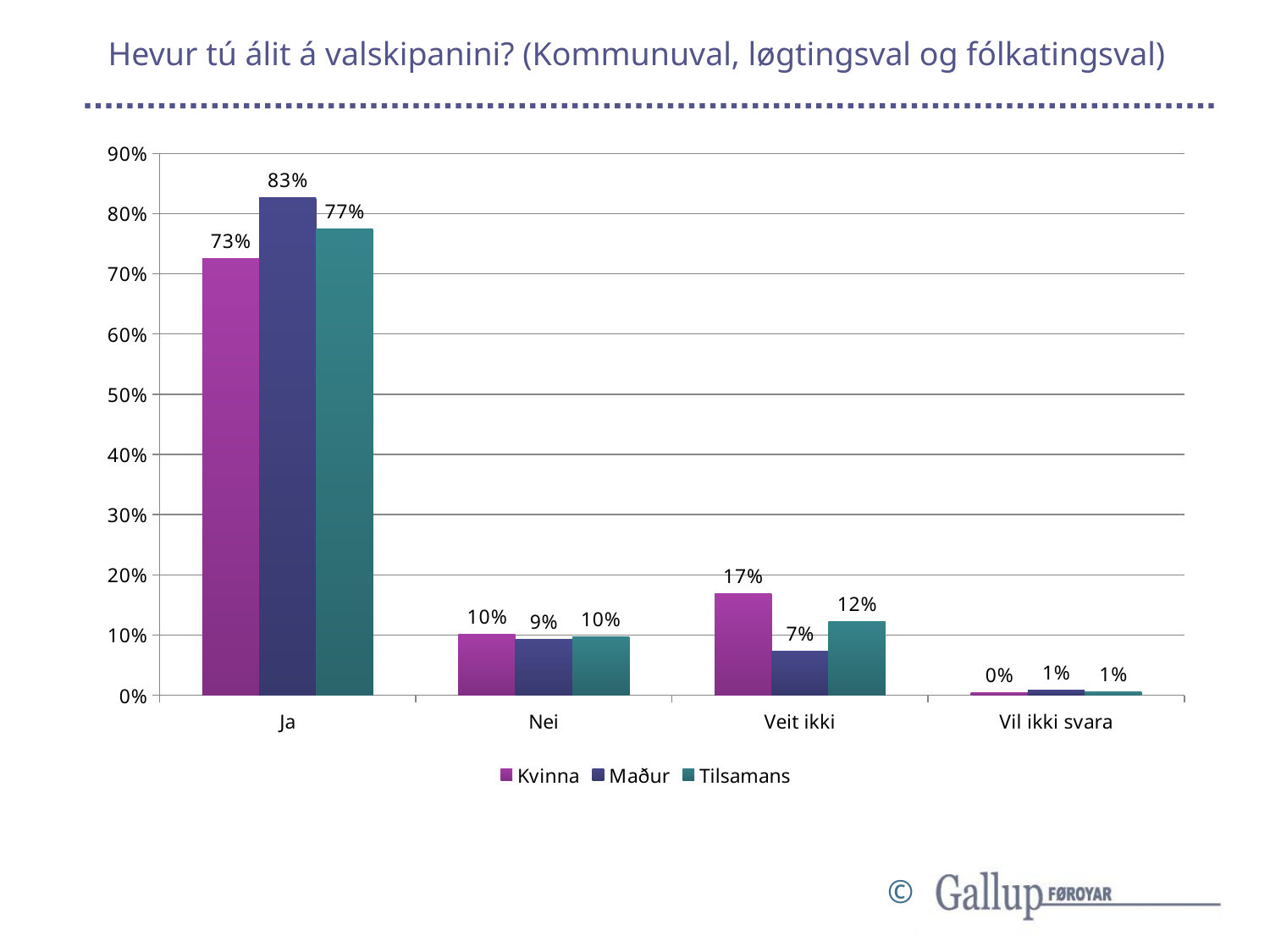
In the Veit ikki category, which is larger: Kvinna or Tilsamans? Kvinna How many categories are shown on the x axis? 4 What is the title of the chart? Hevur tú álit á valskipanini? (Kommunuval, løgtingsval og fólkatingsval) What is the difference between the Maður and Kvinna values in the Ja category? 10% How many series does the legend list? 3 Which category has the lowest value for Kvinna? Vil ikki svara What is the value for Kvinna in the Ja category? 73% What is the value for Maður in the Veit ikki category? 7% What kind of chart is shown on the slide? Bar chart What is the value for Tilsamans in the Nei category? 10% Is the value for Tilsamans in the Ja category greater or less than 70%? greater Which category has the highest value for Maður? Ja